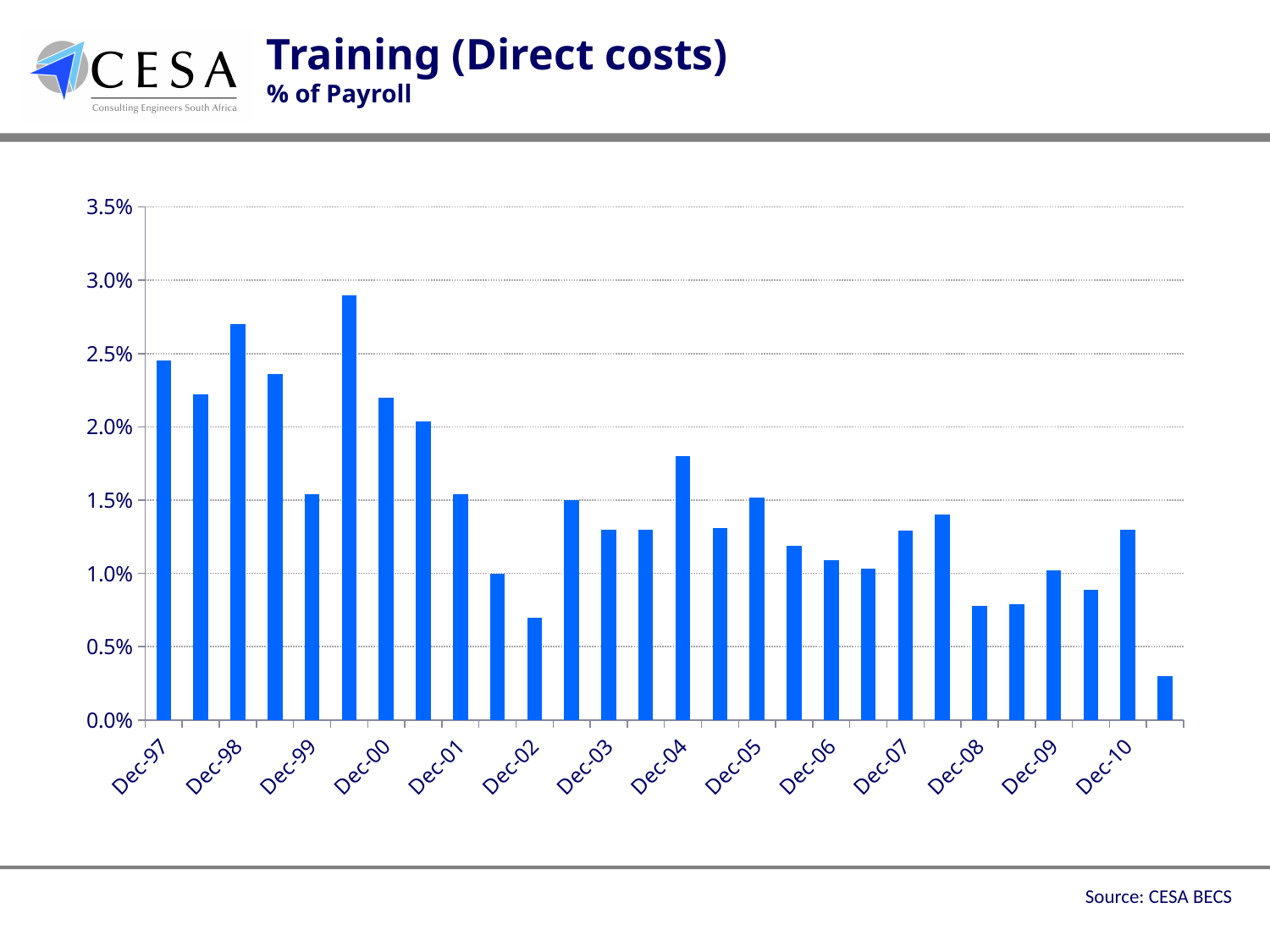
Is the value for Dec-98 greater or less than 2.5%? greater Is the value for Dec-08 greater or less than 1.0%? less How many date labels are shown on the x axis? 14 Which is larger, the value for Dec-98 or the value for Dec-02? Dec-98 What is the title of the chart on the slide? Training (Direct costs) % of Payroll Is the value for Dec-02 greater or less than 1.0%? less What is the highest value shown on the y axis? 3.5% What kind of chart is shown on the slide? bar chart How many bars are plotted in the chart? 28 Overall, do the values rise or fall from Dec-97 to Dec-10? fall